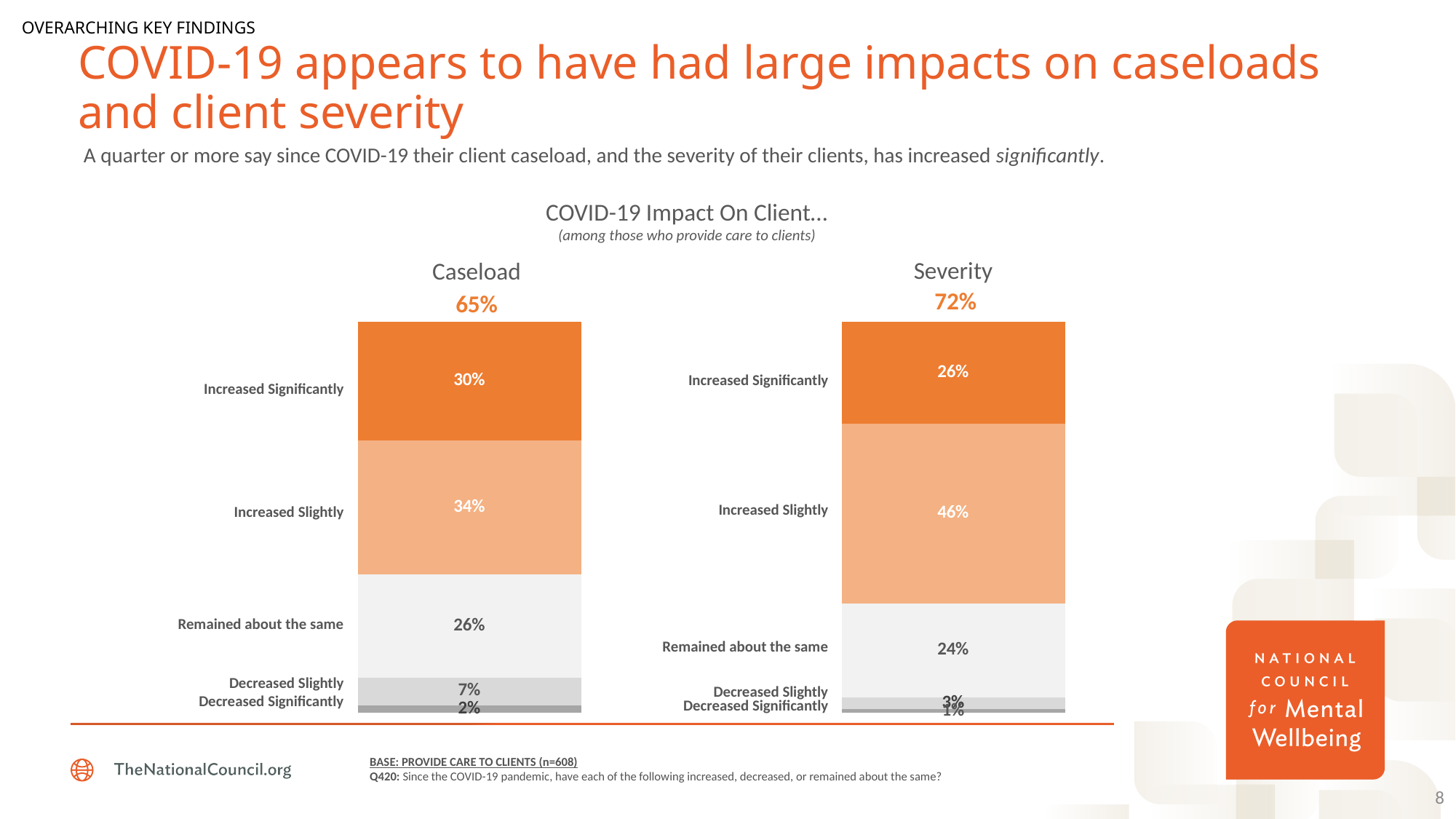
In the Severity chart, what percentage said client severity decreased significantly? 1% How many response categories are shown in the Caseload chart? 5 In the Caseload chart, what percentage said their caseload remained about the same? 26% In the Caseload chart, what is the difference between the Increased Slightly and Increased Significantly percentages? 4% In the Severity chart, what percentage said client severity increased slightly? 46% What type of chart is used to show the Caseload and Severity results? Stacked bar chart In the Caseload chart, what percentage said their caseload increased significantly? 30% Which is larger: the Increased Significantly share in the Caseload chart or in the Severity chart? Caseload In the Severity chart, which response category has the largest share? Increased Slightly In the Caseload chart, which response category has the smallest share? Decreased Significantly What is the combined percentage shown above the Caseload bar for those who said caseload increased? 65% What is the combined percentage shown above the Severity bar for those who said severity increased? 72%